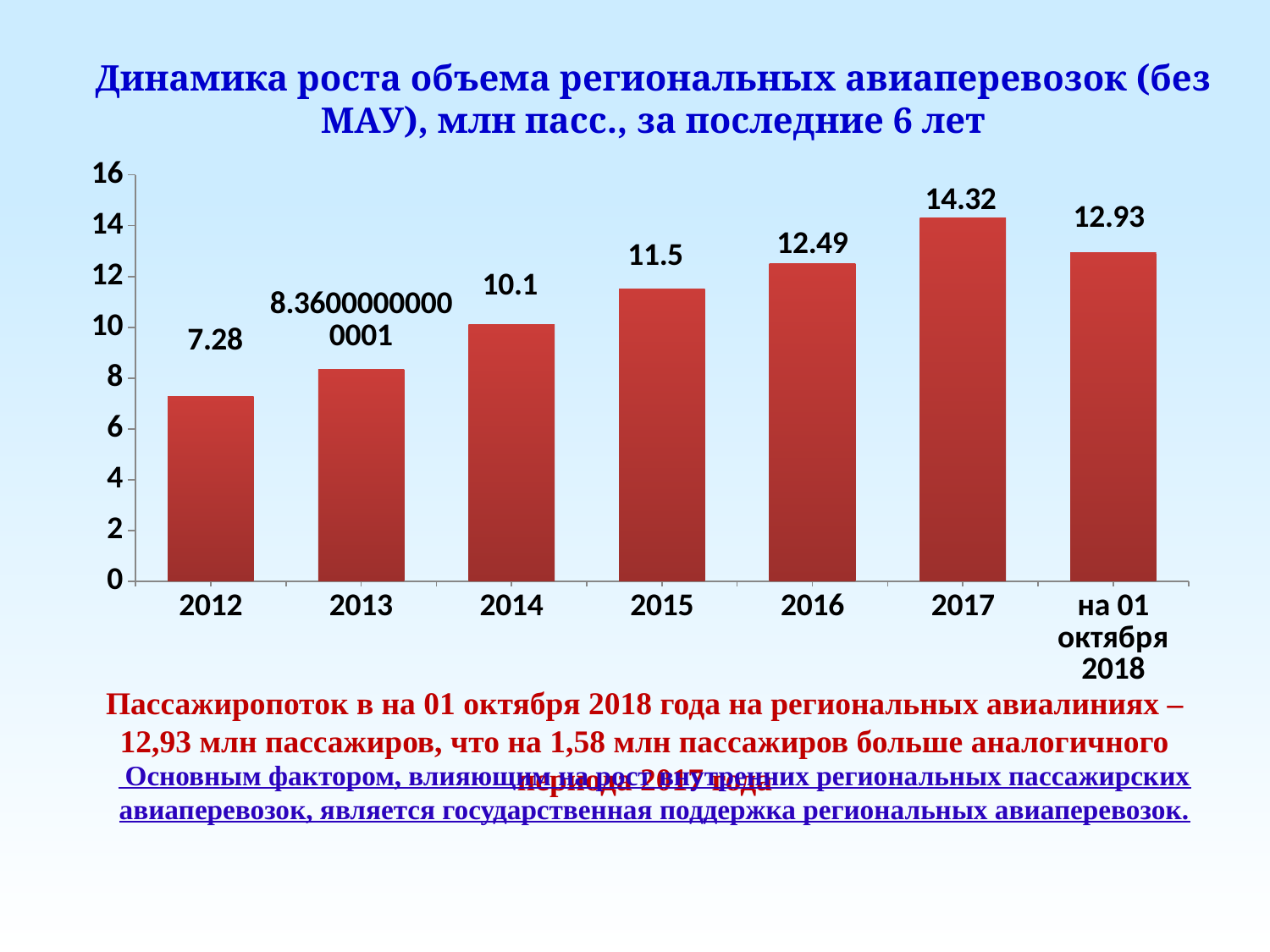
Do the values rise or fall from 2012 to 2017? rise What is the value for 2012? 7.28 What is the difference between the values for 2015 and 2014? 1.4 Which is larger, the value for 2016 or the value for на 01 октября 2018? на 01 октября 2018 What is the difference between the values for 2017 and 2016? 1.83 What is the value for 2017? 14.32 How many categories are shown on the x axis? 7 What kind of chart is shown on the slide? bar chart What is the value for 2015? 11.5 What is the value for на 01 октября 2018? 12.93 Which year has the highest value? 2017 Which category has the lowest value? 2012